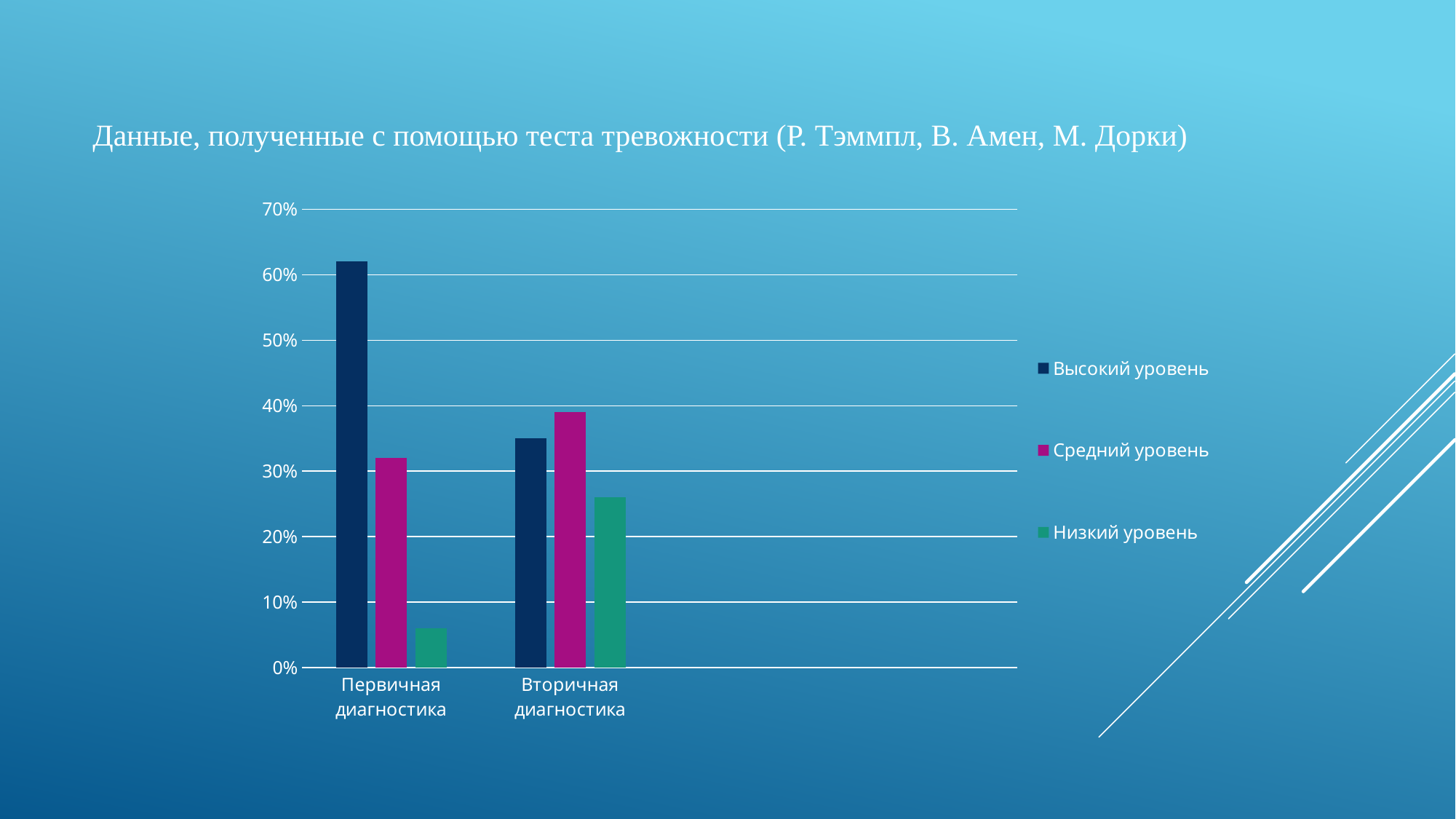
What colour are the bars for Средний уровень? magenta Which series has the highest value for Первичная диагностика? Высокий уровень What kind of chart is shown on the slide? bar chart Is the value for Высокий уровень at Первичная диагностика greater or less than 60%? greater Is the value for Низкий уровень at Первичная диагностика greater or less than 10%? less Which series has the lowest value for Первичная диагностика? Низкий уровень Which is larger: Высокий уровень at Первичная диагностика or Высокий уровень at Вторичная диагностика? Первичная диагностика How many series does the legend list? 3 Is the value for Низкий уровень at Вторичная диагностика greater or less than 20%? greater How many categories are shown on the x axis? 2 Which series has the lowest value for Вторичная диагностика? Низкий уровень Does the value for Низкий уровень rise or fall from Первичная диагностика to Вторичная диагностика? rise